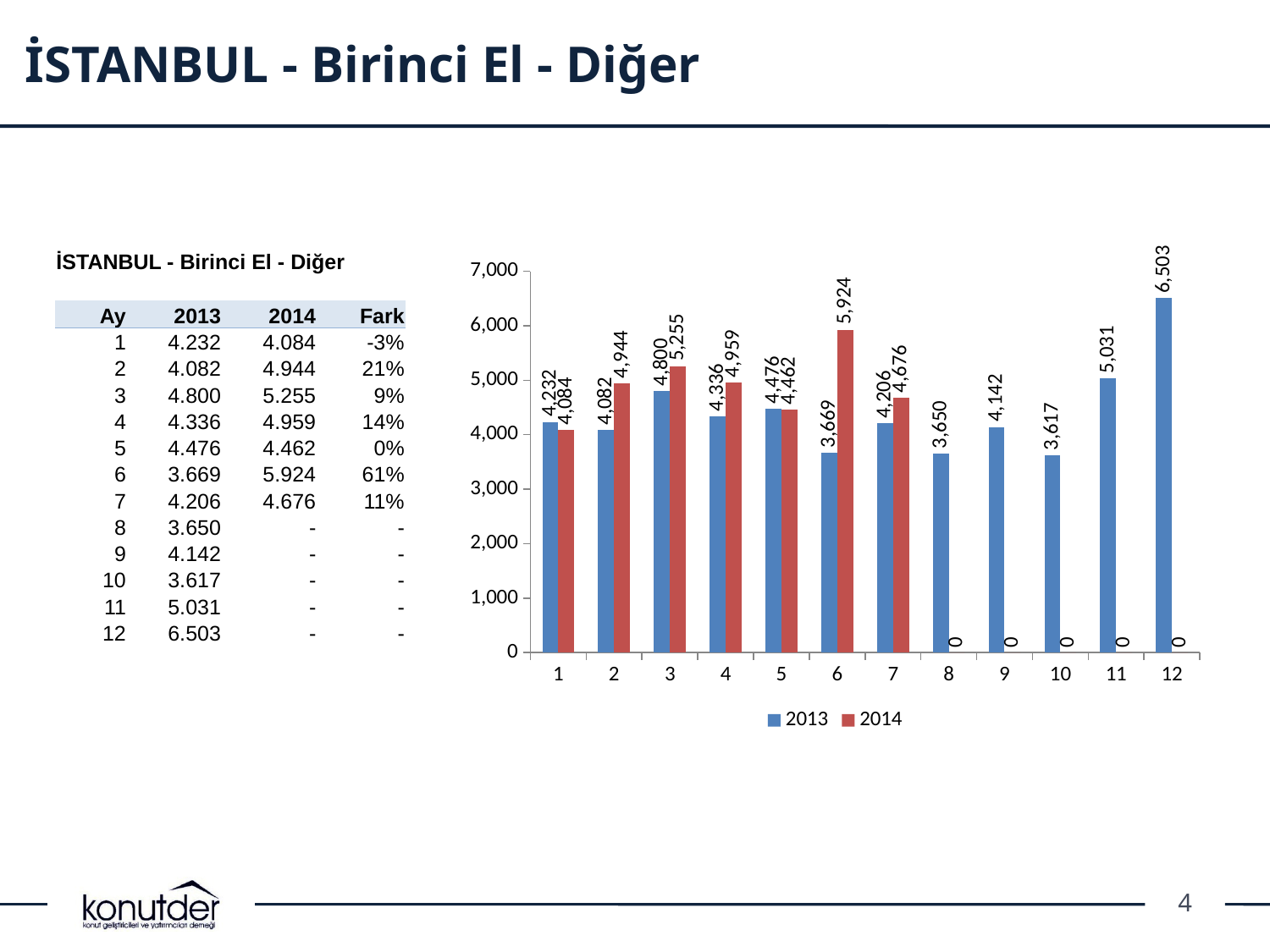
Is the value for 2013 in month 8 greater or less than 4,000? less What is the value for 2013 in month 10? 3,617 What is the difference between the 2014 and 2013 values in month 3? 455 What is the value for 2013 in month 12? 6,503 In month 1, which series has the larger value, 2013 or 2014? 2013 Which month has the lowest value for the 2013 series? 10 Which month has the highest value for the 2014 series? 6 What is the value for 2014 in month 6? 5,924 How many months are shown on the x axis of the chart? 12 What is the difference between the 2014 and 2013 values in month 6? 2,255 Which month has the highest value for the 2013 series? 12 How many series does the chart legend list? 2